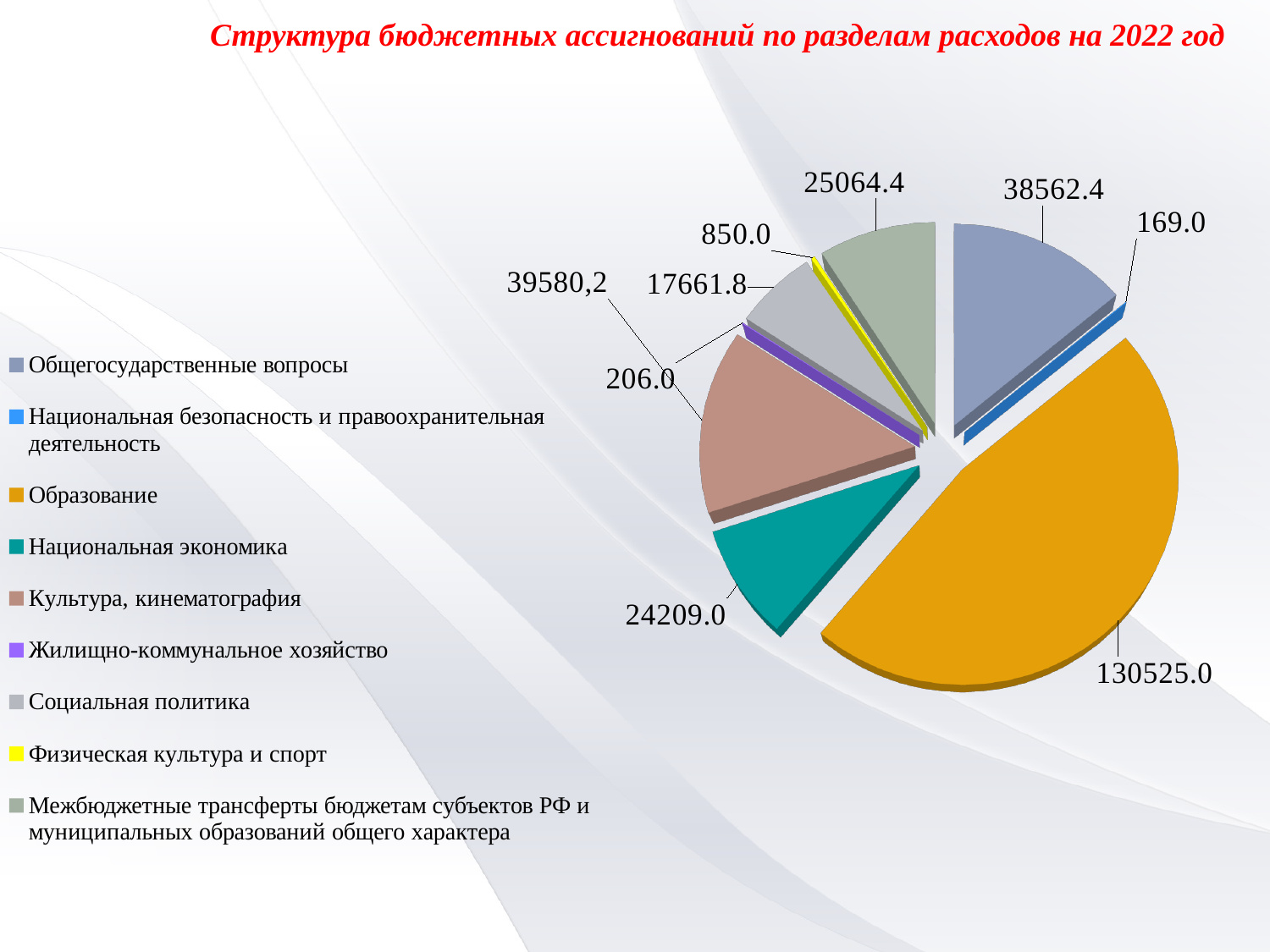
What is the title of the chart? Структура бюджетных ассигнований по разделам расходов на 2022 год Which category has the smallest value in the pie chart? Национальная безопасность и правоохранительная деятельность What is the value shown for Физическая культура и спорт? 850.0 What is the value shown for Образование? 130525.0 What is the value shown for Социальная политика? 17661.8 What is the value shown for Общегосударственные вопросы? 38562.4 How many categories does the legend of the pie chart list? 9 What colour is the slice for Жилищно-коммунальное хозяйство? Purple What type of chart is shown on the slide? Pie chart What is the difference between the values for Образование and Общегосударственные вопросы? 91962.6 Which is larger: the value for Национальная экономика or for Социальная политика? Национальная экономика Which category has the largest slice of the pie? Образование